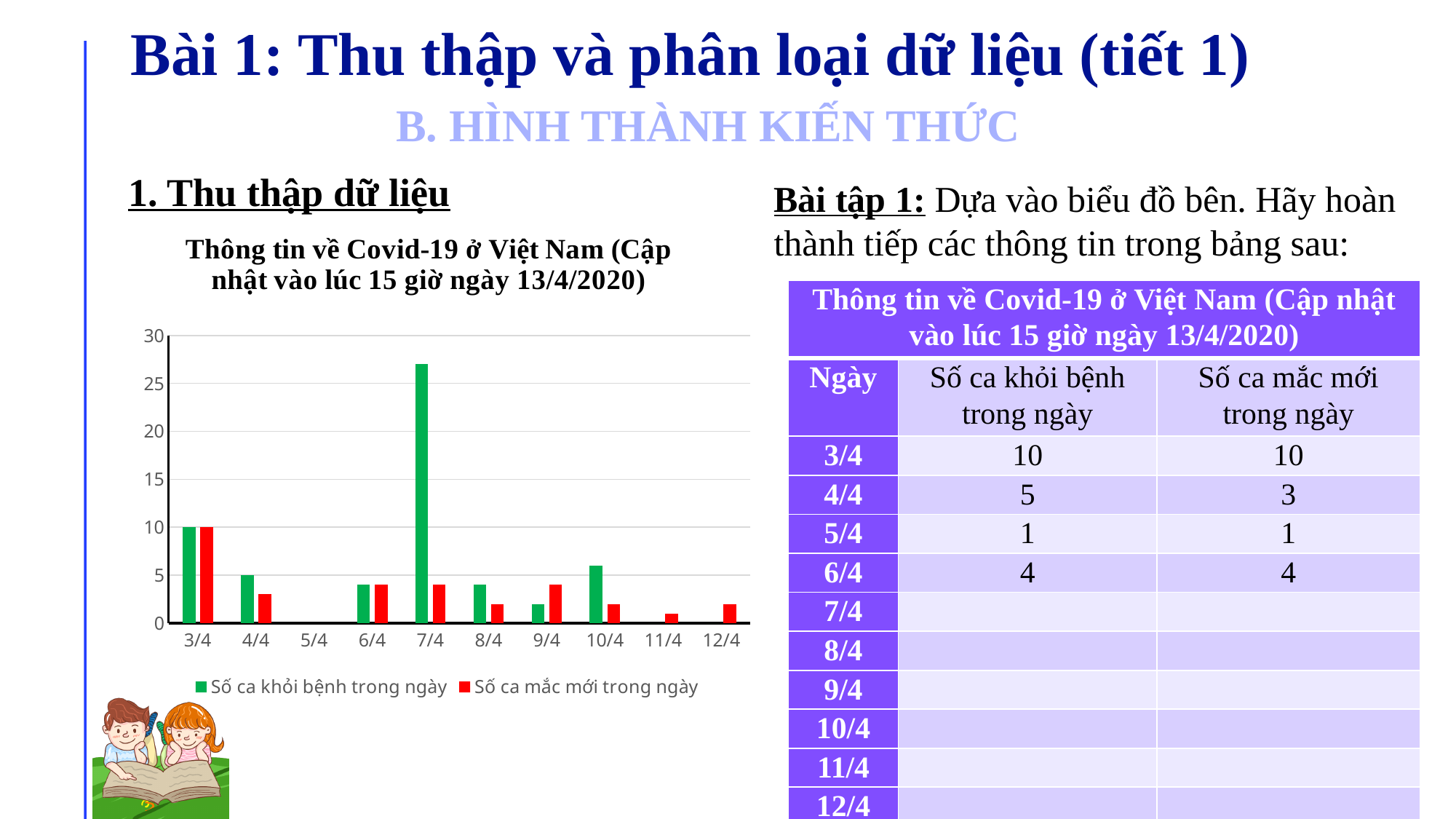
On which date is the value for 'Số ca mắc mới trong ngày' highest? 3/4 What is the value for 'Số ca khỏi bệnh trong ngày' on 4/4? 5 On which date is the value for 'Số ca khỏi bệnh trong ngày' highest? 7/4 Is the value for 'Số ca mắc mới trong ngày' on 11/4 greater or less than 5? less Is the value for 'Số ca khỏi bệnh trong ngày' on 7/4 greater or less than 25? greater What kind of chart is shown on the slide? bar chart Is the value for 'Số ca khỏi bệnh trong ngày' on 10/4 greater or less than 10? less What is the value for 'Số ca khỏi bệnh trong ngày' on 3/4? 10 How many dates are shown along the x axis of the chart? 10 How many series does the chart legend list? 2 On 9/4, which series has the larger value: 'Số ca khỏi bệnh trong ngày' or 'Số ca mắc mới trong ngày'? Số ca mắc mới trong ngày Which colour represents 'Số ca mắc mới trong ngày' in the chart? red